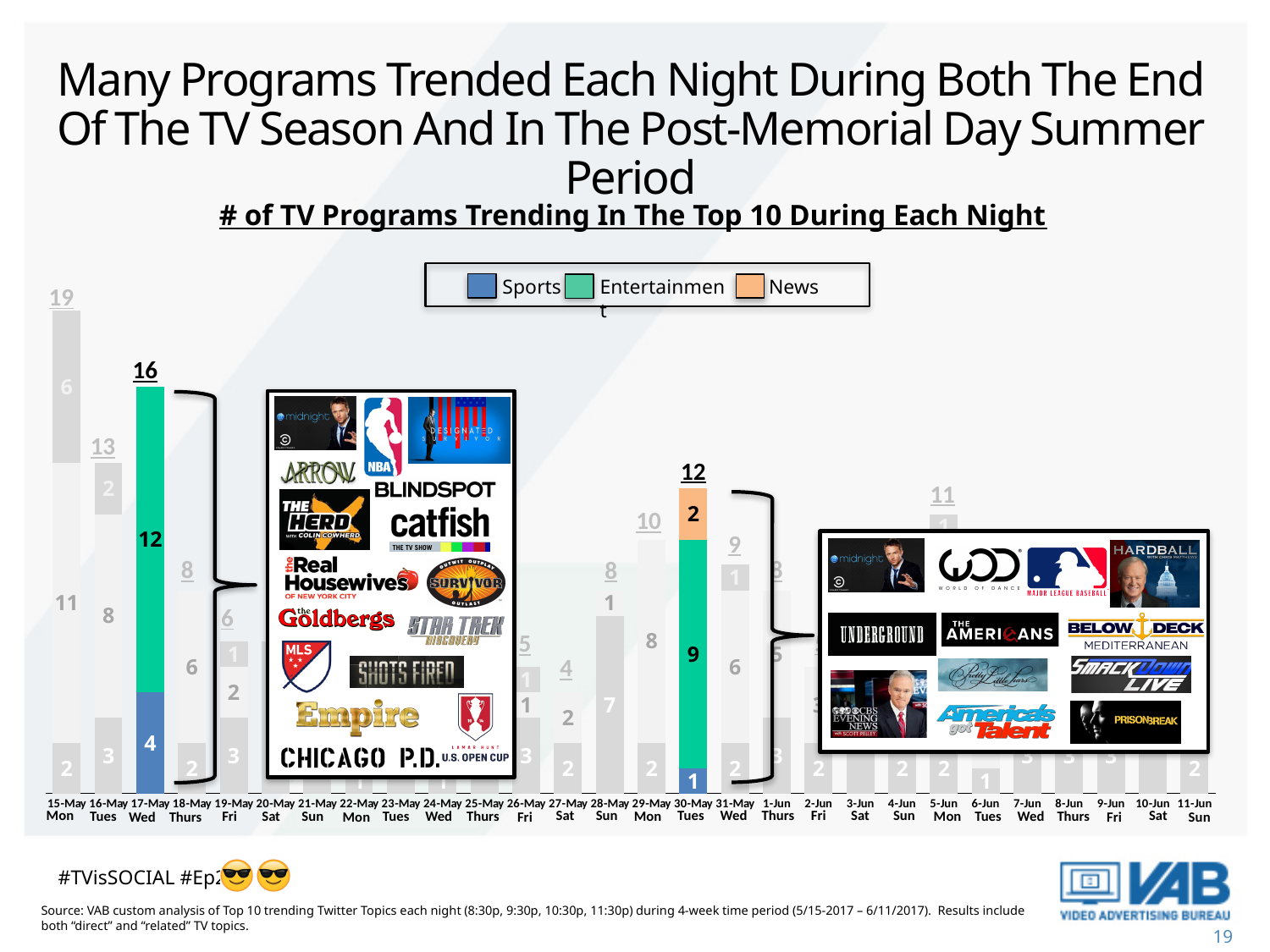
How many Entertainment programs trended in the Top 10 on 17-May (Wed)? 12 How many News programs trended in the Top 10 on 30-May (Tues)? 2 How many series does the legend list? 3 What kind of chart is shown on the slide? Stacked bar chart What is the total number of TV programs trending on 30-May (Tues)? 12 How many more Entertainment programs trended on 17-May than on 30-May? 3 How many nights (dates) are shown along the x axis? 28 What is the total number of TV programs trending on 17-May (Wed)? 16 How many Sports programs trended in the Top 10 on 17-May (Wed)? 4 Which night has the highest total number of trending programs? 15-May (Mon) How many Sports programs trended in the Top 10 on 30-May (Tues)? 1 How many Entertainment programs trended in the Top 10 on 30-May (Tues)? 9